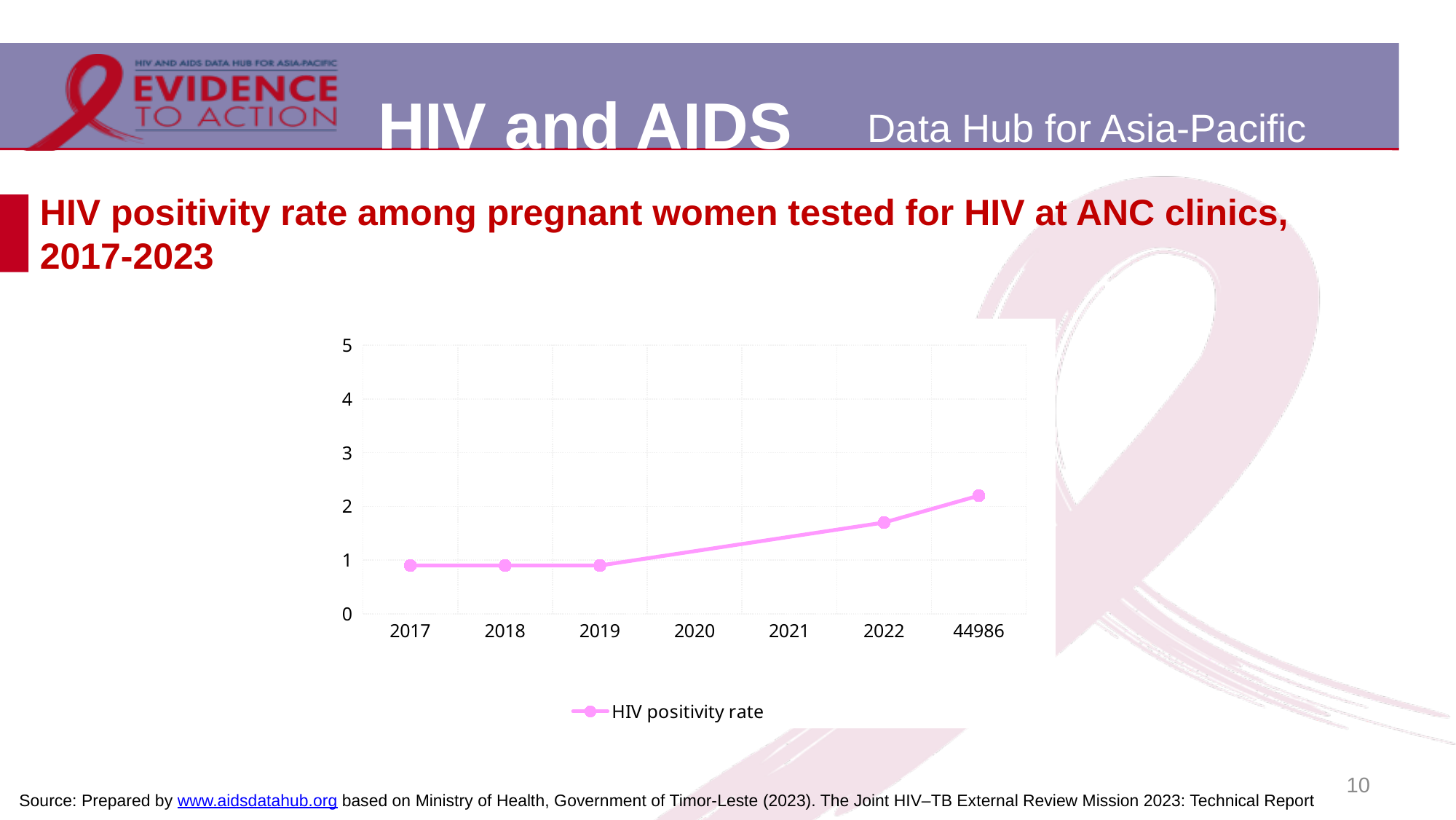
What kind of chart is shown on the slide? line chart Does the HIV positivity rate rise or fall from 2019 to the last point on the x axis? rise Is the HIV positivity rate for the last point (labelled 44986) greater or less than 2? greater How many series does the legend list? 1 How many category labels are shown on the x axis? 7 What is the name of the series shown in the legend? HIV positivity rate Which x-axis category has the highest HIV positivity rate? 44986 Is the HIV positivity rate for 2022 greater or less than 1? greater Which has a higher HIV positivity rate, 2019 or 2022? 2022 Is the HIV positivity rate for 2022 greater or less than 2? less How many data points are plotted on the line? 5